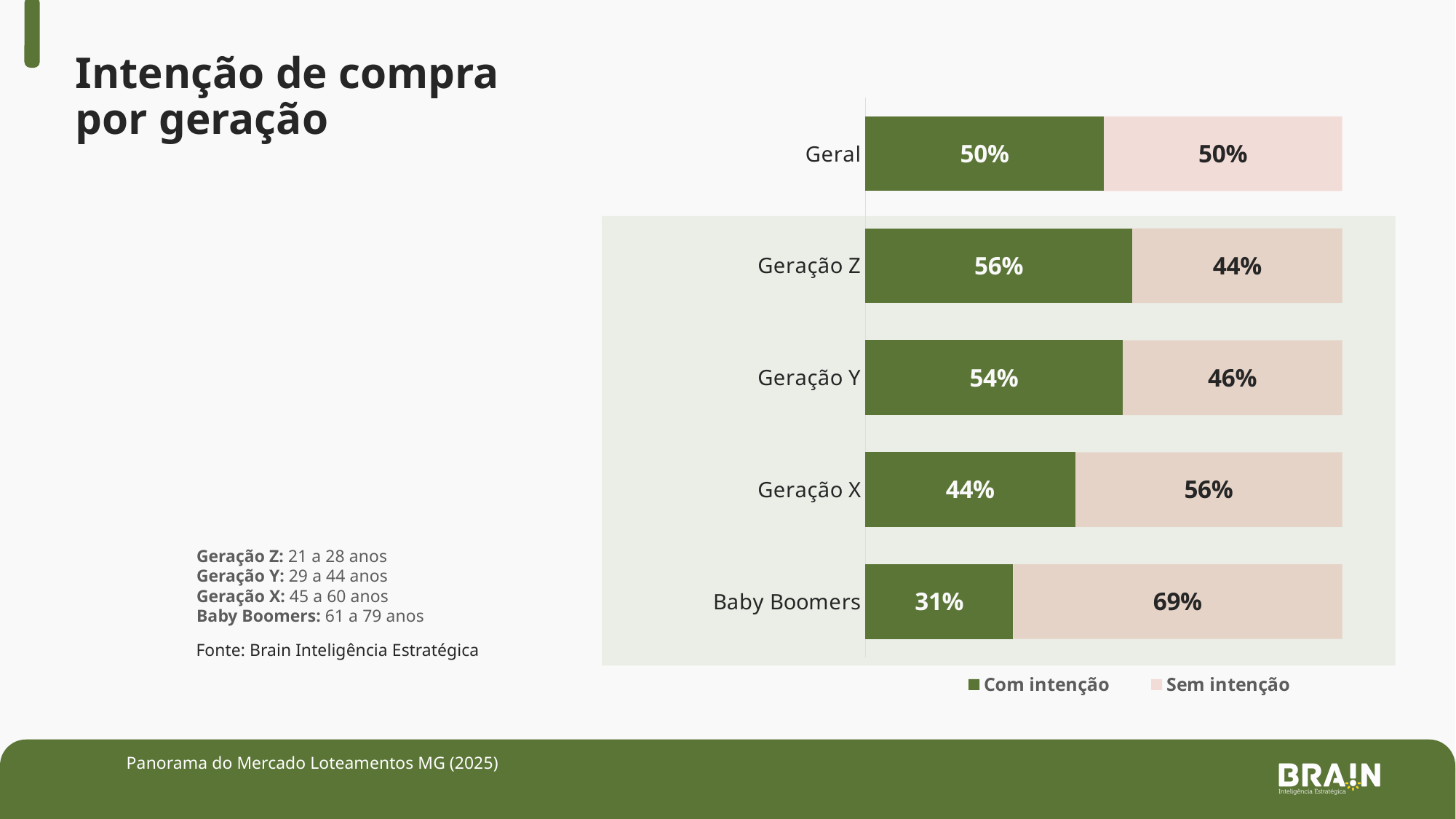
What is the "Sem intenção" value for Baby Boomers? 69% How many categories are shown on the chart? 5 What kind of chart is shown on the slide? Stacked bar chart What is the difference between the "Sem intenção" value for Baby Boomers and the "Sem intenção" value for Geração Z? 25% How many series does the legend list? 2 What is the "Sem intenção" value for Geração Y? 46% Which category has the highest "Com intenção" value? Geração Z What is the "Com intenção" value for Geração Z? 56% What is the "Com intenção" value for Geração X? 44% Which is larger: the "Com intenção" value for Geração Y or the "Com intenção" value for Geração X? Geração Y Which category has the lowest "Com intenção" value? Baby Boomers What is the total of the stacked bar for Geral? 100%